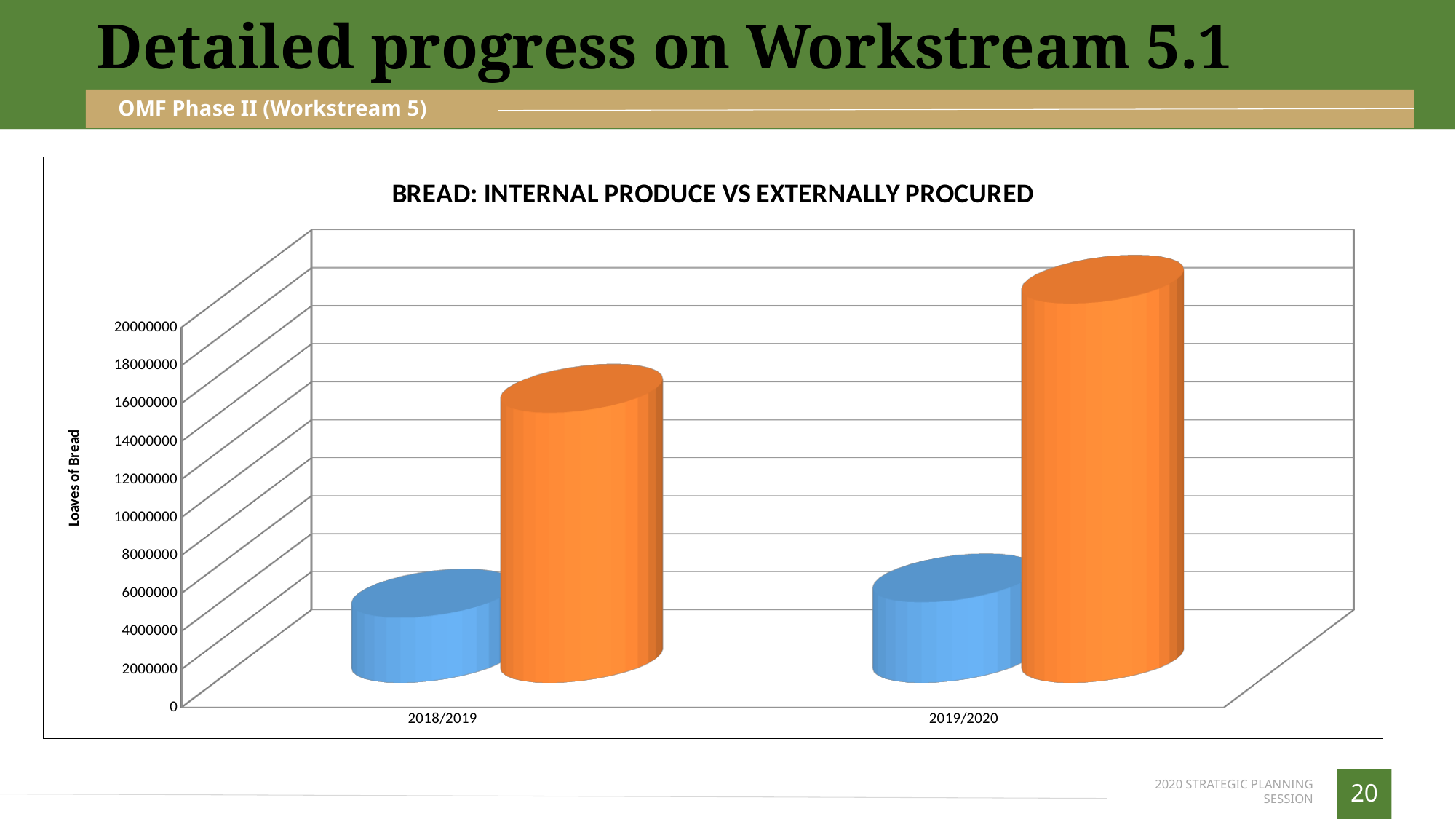
For 2018/2019, which bar is larger, the blue bar or the orange bar? Orange bar Which category has the tallest orange bar? 2019/2020 Is the value of the blue bar for 2018/2019 greater or less than 10000000? less What kind of chart is shown on the slide? Bar chart How many bars are plotted for each category on the chart? 2 Which category has the shortest orange bar? 2018/2019 How many categories are shown on the x axis of the chart? 2 Does the orange series rise or fall from 2018/2019 to 2019/2020? Rise Is the value of the orange bar for 2019/2020 greater or less than 14000000? greater For 2019/2020, which bar is larger, the blue bar or the orange bar? Orange bar What is the label on the vertical axis of the chart? Loaves of Bread What is the title of the chart? BREAD: INTERNAL PRODUCE VS EXTERNALLY PROCURED